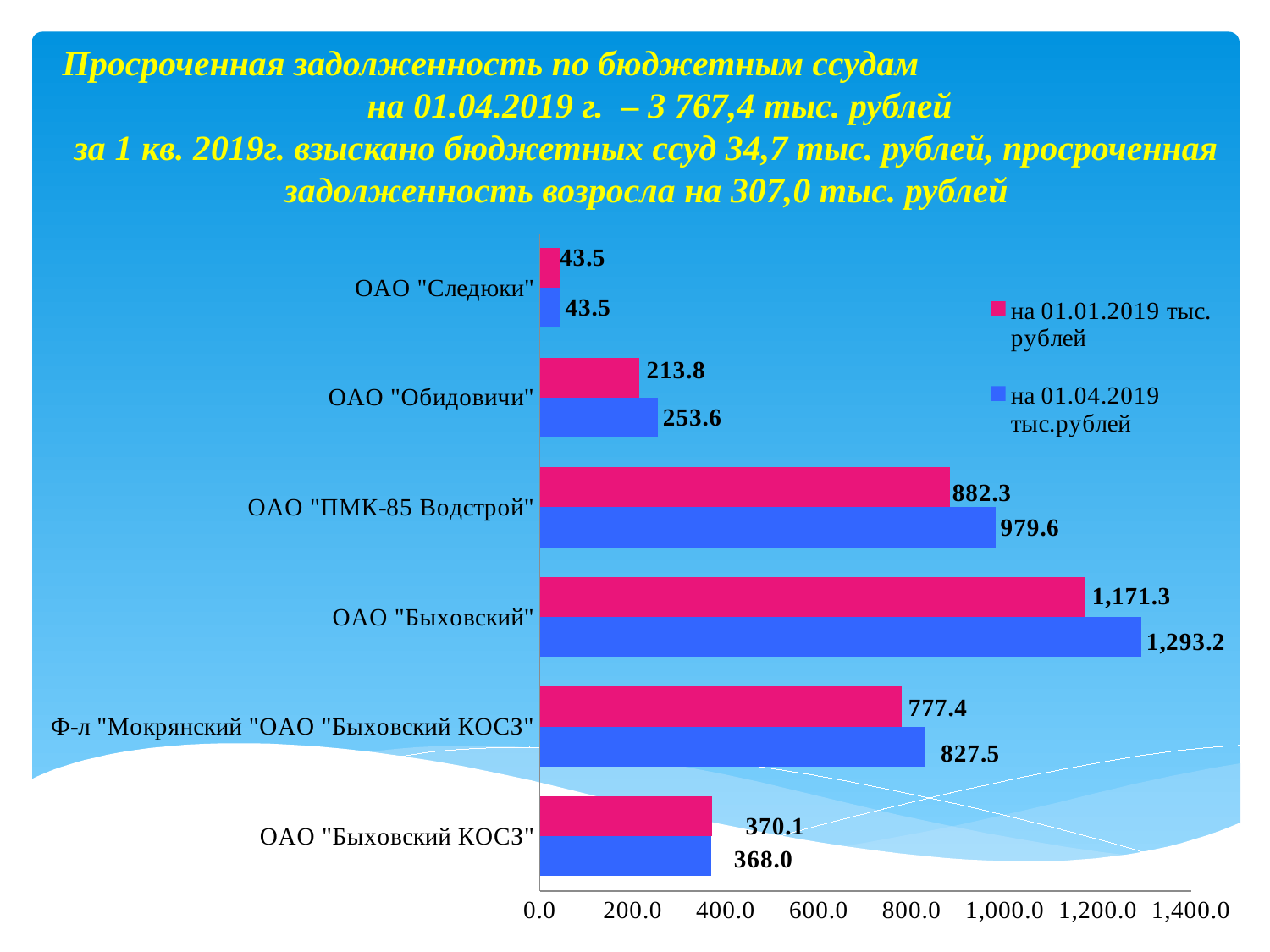
Which category has the highest value in the series "на 01.04.2019 тыс.рублей"? ОАО "Быховский" What is the value for ОАО "ПМК-85 Водстрой" in the series "на 01.01.2019 тыс. рублей"? 882.3 Which category has the lowest value in the series "на 01.01.2019 тыс. рублей"? ОАО "Следюки" How many categories (organisations) are shown on the chart? 6 For Ф-л "Мокрянский "ОАО "Быховский КОСЗ", which series has the larger value: "на 01.01.2019 тыс. рублей" or "на 01.04.2019 тыс.рублей"? на 01.04.2019 тыс.рублей Which colour represents the series "на 01.01.2019 тыс. рублей" in the legend? pink What is the value for ОАО "Обидовичи" in the series "на 01.04.2019 тыс.рублей"? 253.6 What type of chart is shown on the slide? bar chart Is the value for ОАО "ПМК-85 Водстрой" in the series "на 01.04.2019 тыс.рублей" greater or less than 800.0? greater What is the difference between the "на 01.04.2019" and "на 01.01.2019" values for ОАО "Быховский"? 121.9 How many series does the legend list? 2 What is the value for ОАО "Быховский КОСЗ" in the series "на 01.04.2019 тыс.рублей"? 368.0